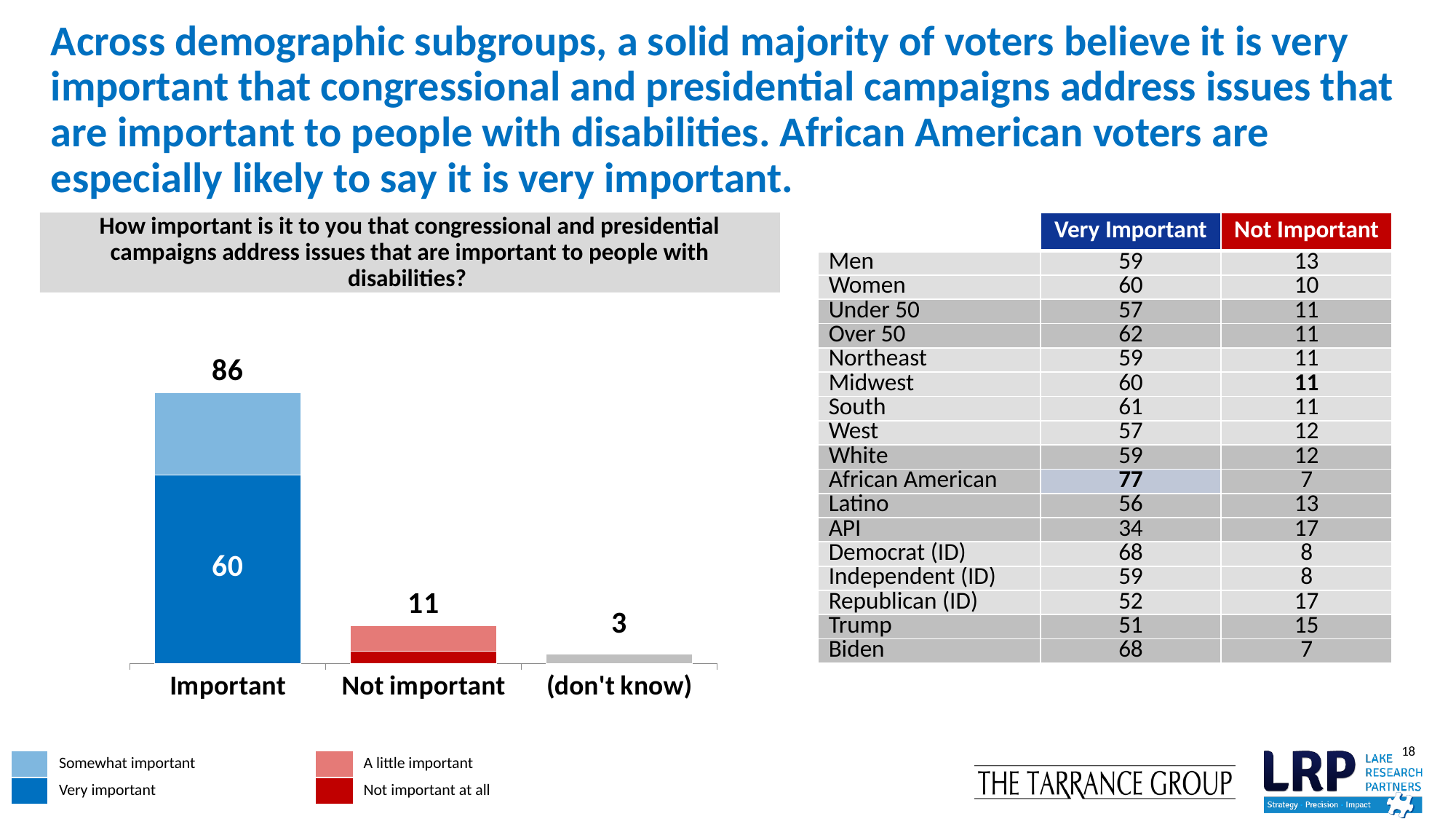
What is the total value shown above the 'Important' bar? 86 What is the value shown for the '(don't know)' category? 3 What is the value shown above the 'Not important' bar? 11 How many entries does the chart's legend list? 4 How many categories are shown on the x axis of the chart? 3 What is the difference between the 'Important' bar total (86) and its 'Very important' segment (60)? 26 What value is printed inside the 'Very important' segment of the 'Important' bar? 60 Which category has the highest total value in the chart? Important What is the difference between the total for 'Important' and the total for 'Not important'? 75 Which category has the lowest value in the chart? (don't know) Which is larger, the total for 'Important' or the total for 'Not important'? Important What kind of chart is shown on the left of the slide? Stacked bar chart